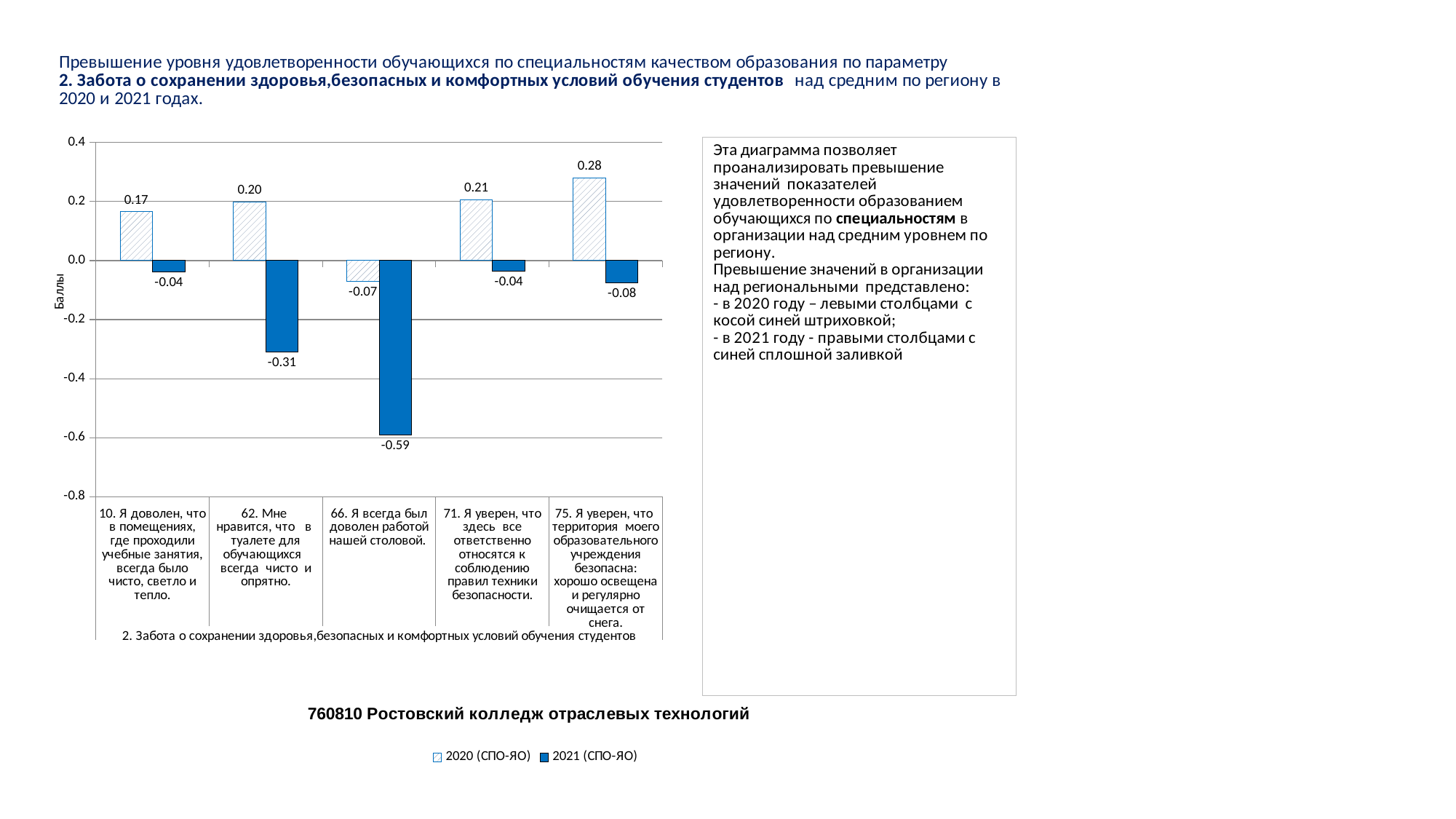
Which category has the lowest value for the 2021 (СПО-ЯО) series? 66. Я всегда был доволен работой нашей столовой How many categories are shown on the x axis of the chart? 5 What is the value for 2021 (СПО-ЯО) for category 62 (Мне нравится, что в туалете для обучающихся всегда чисто и опрятно)? -0.31 What kind of chart is shown on the slide? Bar chart How many series does the chart legend list? 2 What is the label of the vertical axis of the chart? Баллы What is the value for 2020 (СПО-ЯО) for category 10 (Я доволен, что в помещениях, где проходили учебные занятия, всегда было чисто, светло и тепло)? 0.17 Which is larger: the 2020 (СПО-ЯО) value for category 62 or the 2020 (СПО-ЯО) value for category 71? Category 71 (0.21) What is the difference between the 2020 (СПО-ЯО) and 2021 (СПО-ЯО) values for category 71 (Я уверен, что здесь все ответственно относятся к соблюдению правил техники безопасности)? 0.25 What is the value for 2021 (СПО-ЯО) for category 66 (Я всегда был доволен работой нашей столовой)? -0.59 What is the value for 2020 (СПО-ЯО) for category 75 (Я уверен, что территория моего образовательного учреждения безопасна)? 0.28 Which category has the highest value for the 2020 (СПО-ЯО) series? 75. Я уверен, что территория моего образовательного учреждения безопасна